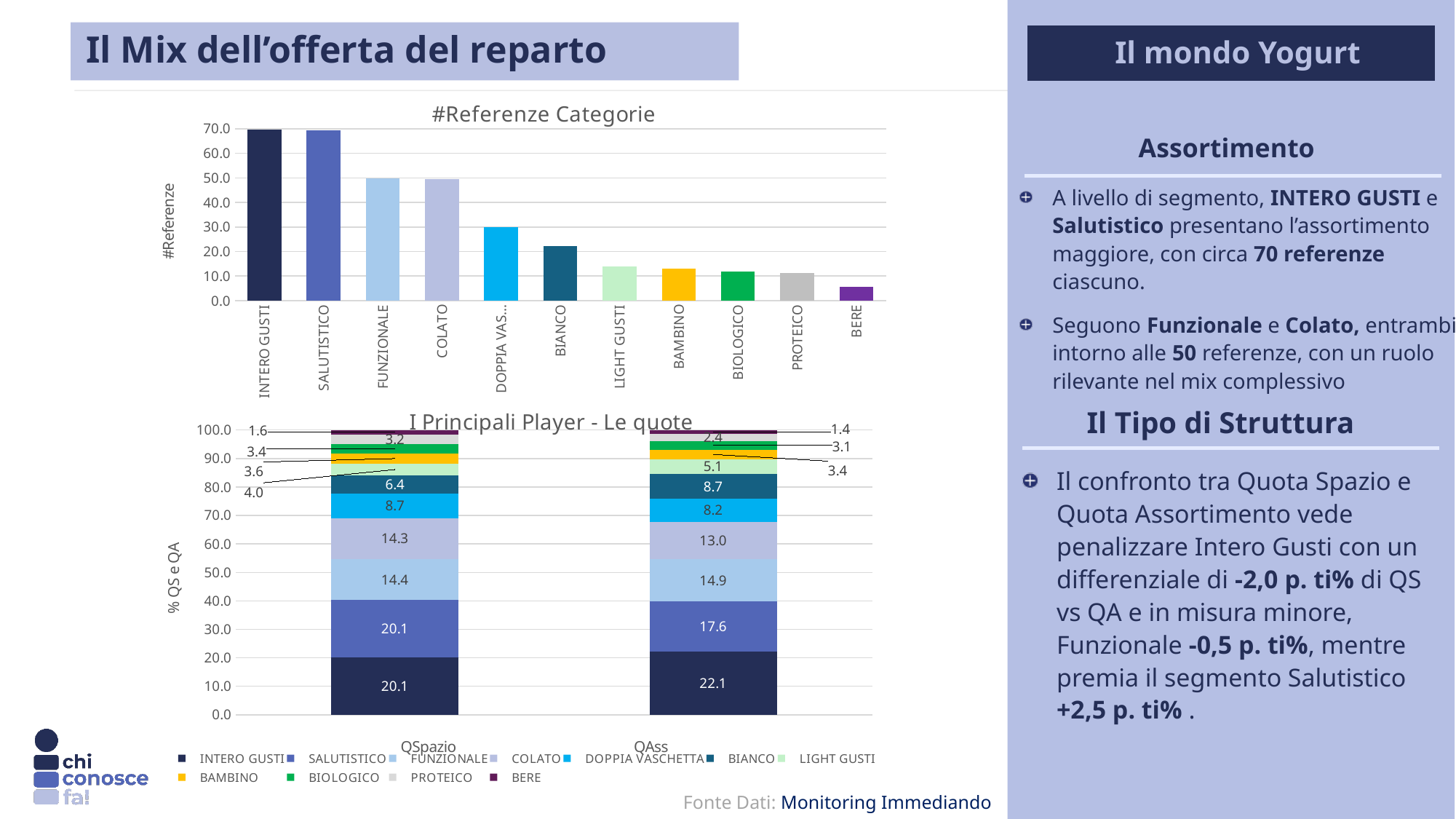
In the bottom chart 'I Principali Player - Le quote', what is the difference between the SALUTISTICO value for QSpazio (20.1) and for QAss (17.6)? 2.5 How many series does the legend of the bottom chart 'I Principali Player - Le quote' list? 11 In the top chart '#Referenze Categorie', which category has the lowest number of references? BERE In the bottom chart 'I Principali Player - Le quote', what is the value of INTERO GUSTI for QAss? 22.1 What kind of chart is the top chart titled '#Referenze Categorie'? bar chart In the top chart '#Referenze Categorie', is the value for FUNZIONALE greater or less than 40? greater In the top chart '#Referenze Categorie', is the value for BIANCO greater or less than 30? less In the bottom chart 'I Principali Player - Le quote', is the COLATO value larger for QSpazio or for QAss? QSpazio What kind of chart is the bottom chart 'I Principali Player - Le quote'? stacked bar chart In the bottom chart 'I Principali Player - Le quote', what is the value of FUNZIONALE for QSpazio? 14.4 How many categories are shown in the top chart '#Referenze Categorie'? 11 In the top chart '#Referenze Categorie', which has more references, BIANCO or LIGHT GUSTI? BIANCO